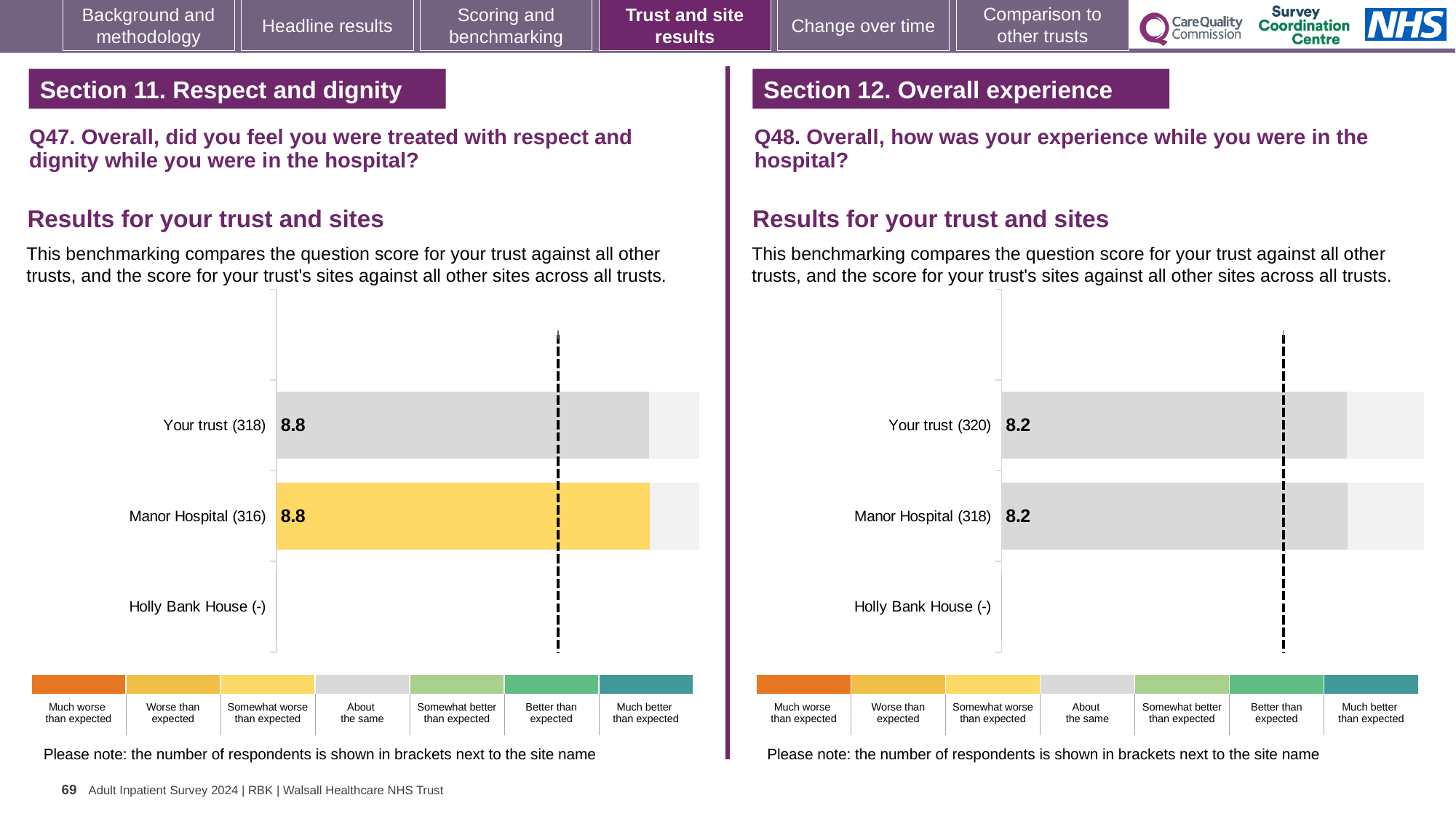
In the Q47 chart on the left, how many respondents are shown in brackets for Manor Hospital? 316 In the Q48 chart on the right, which benchmark category does the grey colour of the Your trust bar correspond to in the legend? About the same In the Q47 chart on the left, what is the score for Manor Hospital? 8.8 In the Q48 chart on the right, what is the score for Manor Hospital? 8.2 In the Q48 chart on the right, how many respondents are shown in brackets for Your trust? 320 In the Q47 chart on the left, which benchmark category does the yellow colour of the Manor Hospital bar correspond to in the legend? Somewhat worse than expected What kind of chart is used in the Q48 chart on the right? Bar chart In the Q48 chart on the right, what is the score for Your trust? 8.2 In the Q47 chart on the left, which category has no score shown? Holly Bank House In the Q47 chart on the left, what is the difference between the scores for Your trust and Manor Hospital? 0.0 In the Q47 chart on the left, how many site/trust categories are listed on the vertical axis? 3 In the Q47 chart on the left, what is the score for Your trust? 8.8